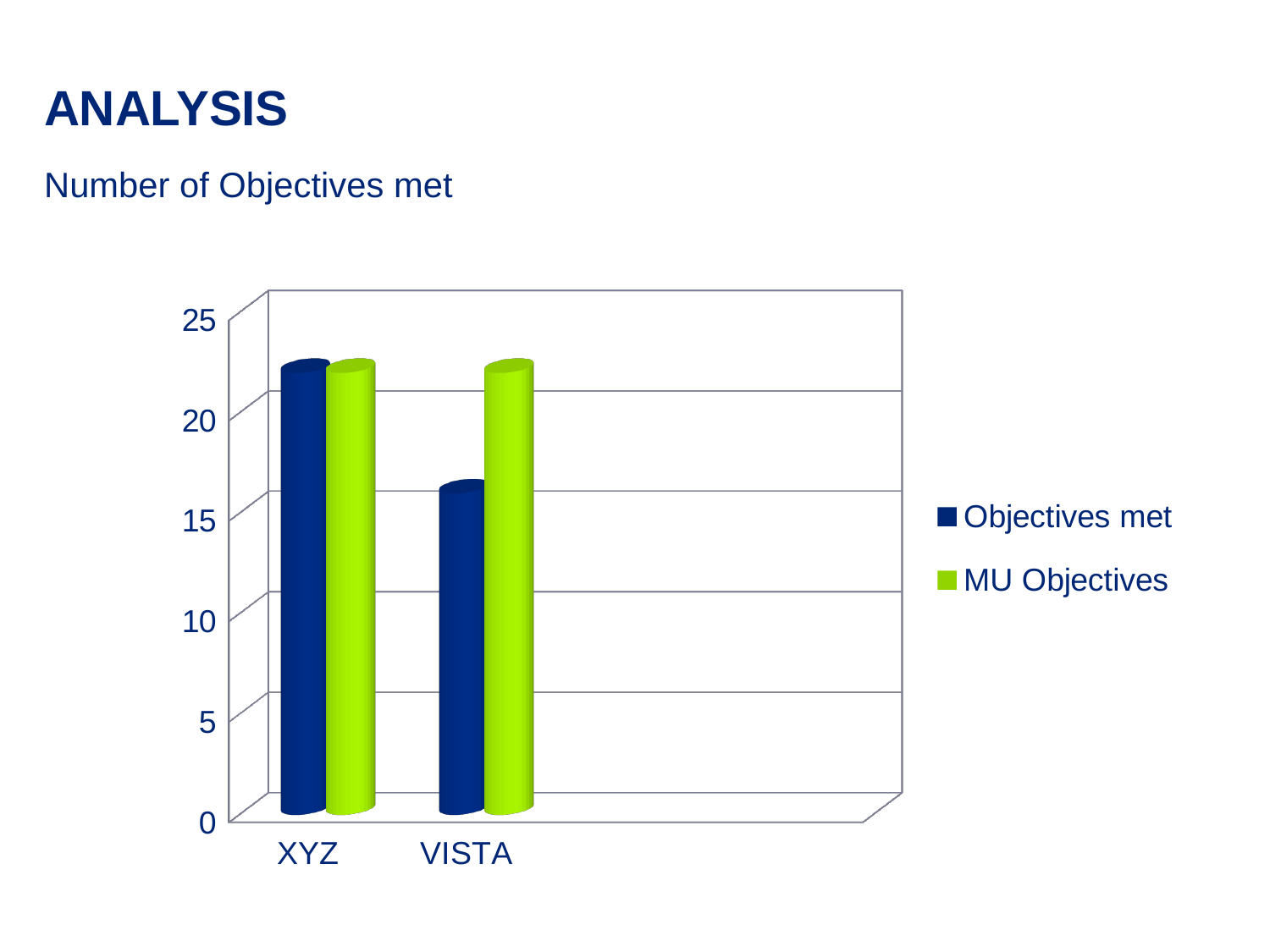
How many categories are shown on the x axis of the chart? 2 Which category has the larger value for Objectives met, XYZ or VISTA? XYZ What colour are the bars for the MU Objectives series? green How many series does the chart's legend list? 2 What are the two series named in the chart's legend? Objectives met and MU Objectives Which category has the highest value for Objectives met? XYZ What kind of chart is shown on the slide? bar chart Is the value for Objectives met for XYZ greater or less than 20? greater Is the value for Objectives met for VISTA greater or less than 20? less For VISTA, which is larger: Objectives met or MU Objectives? MU Objectives Which category has the lowest value for Objectives met? VISTA Is the value for MU Objectives for VISTA greater or less than 20? greater